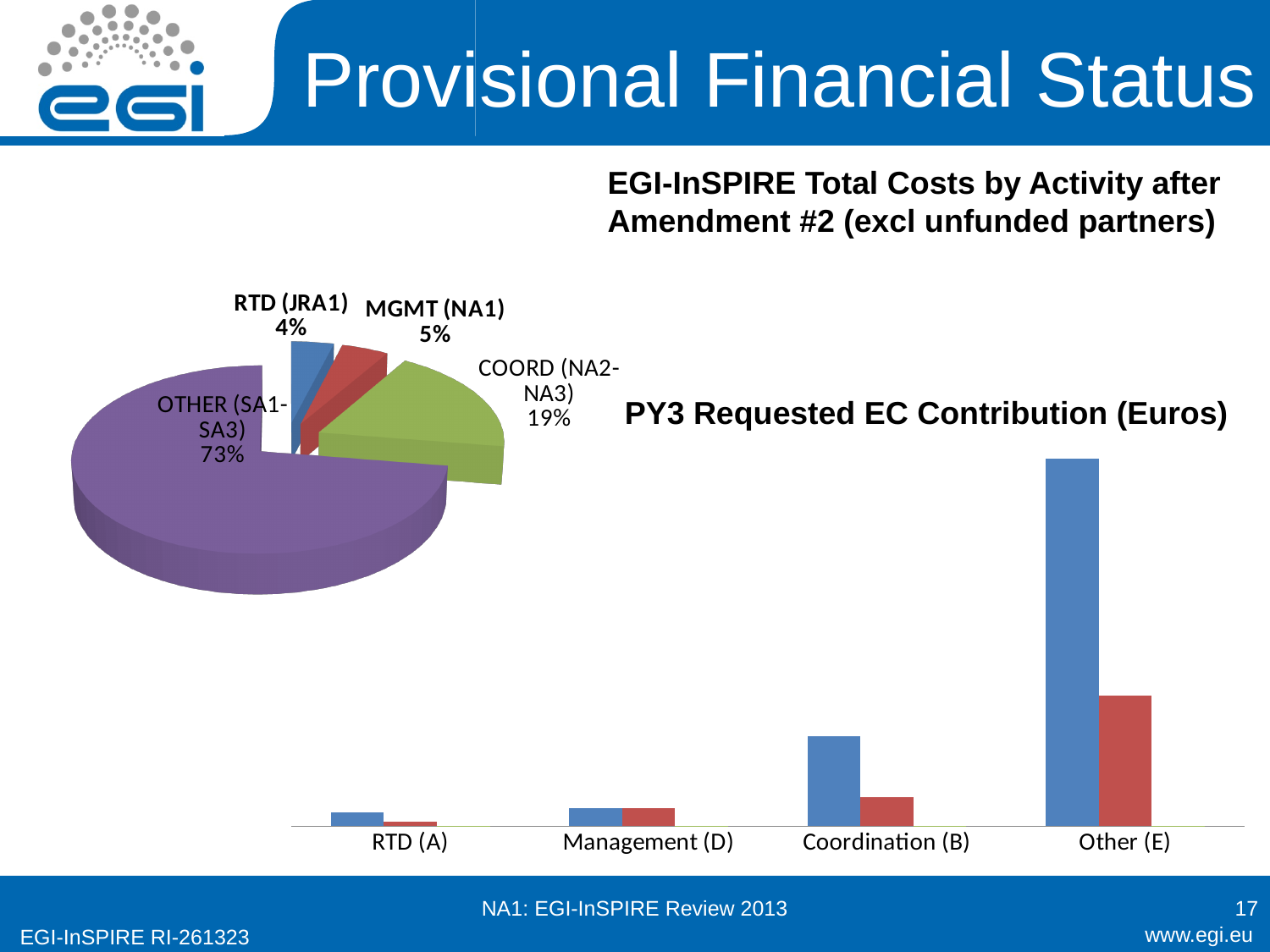
In the chart titled 'PY3 Requested EC Contribution (Euros)', for Other (E), which bar is taller, the blue one or the red one? The blue one In the chart titled 'PY3 Requested EC Contribution (Euros)', which category has the tallest bar? Other (E) In the pie chart titled 'EGI-InSPIRE Total Costs by Activity after Amendment #2 (excl unfunded partners)', how many percentage points larger is OTHER (SA1-SA3) than COORD (NA2-NA3)? 54 In the pie chart titled 'EGI-InSPIRE Total Costs by Activity after Amendment #2 (excl unfunded partners)', what share does COORD (NA2-NA3) have? 19% In the pie chart titled 'EGI-InSPIRE Total Costs by Activity after Amendment #2 (excl unfunded partners)', how many slices are there? 4 In the pie chart titled 'EGI-InSPIRE Total Costs by Activity after Amendment #2 (excl unfunded partners)', which is larger, MGMT (NA1) or RTD (JRA1)? MGMT (NA1) In the pie chart titled 'EGI-InSPIRE Total Costs by Activity after Amendment #2 (excl unfunded partners)', which activity has the smallest share? RTD (JRA1) In the pie chart titled 'EGI-InSPIRE Total Costs by Activity after Amendment #2 (excl unfunded partners)', what share does OTHER (SA1-SA3) have? 73% What kind of chart is the chart titled 'PY3 Requested EC Contribution (Euros)'? Bar chart In the pie chart titled 'EGI-InSPIRE Total Costs by Activity after Amendment #2 (excl unfunded partners)', which activity has the largest share? OTHER (SA1-SA3) In the chart titled 'PY3 Requested EC Contribution (Euros)', how many categories are shown on the x axis? 4 In the pie chart titled 'EGI-InSPIRE Total Costs by Activity after Amendment #2 (excl unfunded partners)', what percentage is shown for MGMT (NA1)? 5%